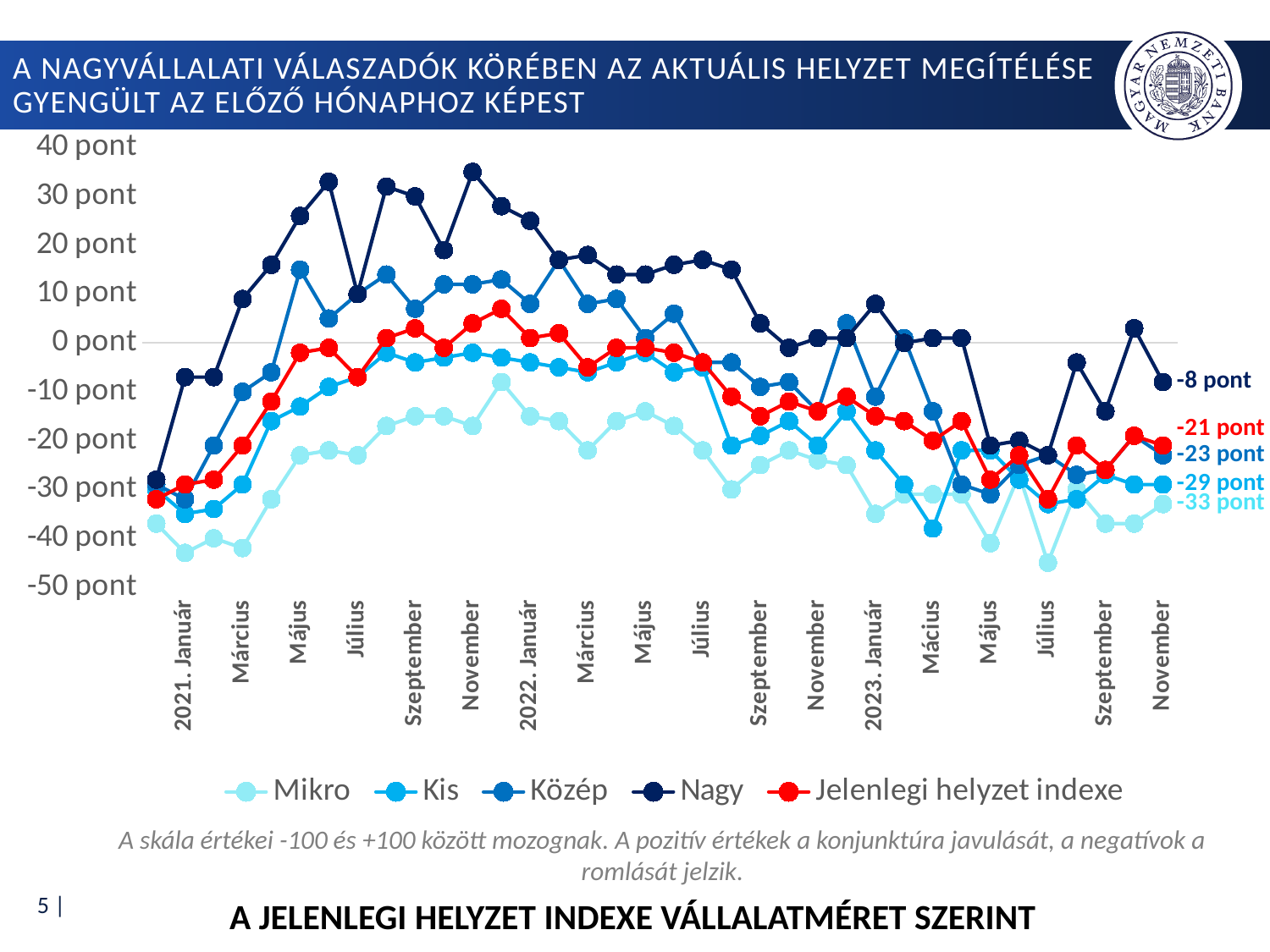
Is the value of the Nagy series at 2021 Május greater or less than 20 pont? greater What is the value of the Kis series at 2023 November? -29 pont What is the value of the Nagy series at the last point (2023 November)? -8 pont What is the value of the Mikro series at 2023 November? -33 pont Which series has the highest value at 2023 November? Nagy Which series has the lowest value at 2023 November? Mikro What is the difference between the Nagy and Mikro values at 2023 November? 25 pont What is the value of the Jelenlegi helyzet indexe series at 2023 November? -21 pont What is the value of the Közép series at 2023 November? -23 pont What kind of chart is shown on the slide? Line chart What is the title shown below the chart? A JELENLEGI HELYZET INDEXE VÁLLALATMÉRET SZERINT How many series does the legend list? 5